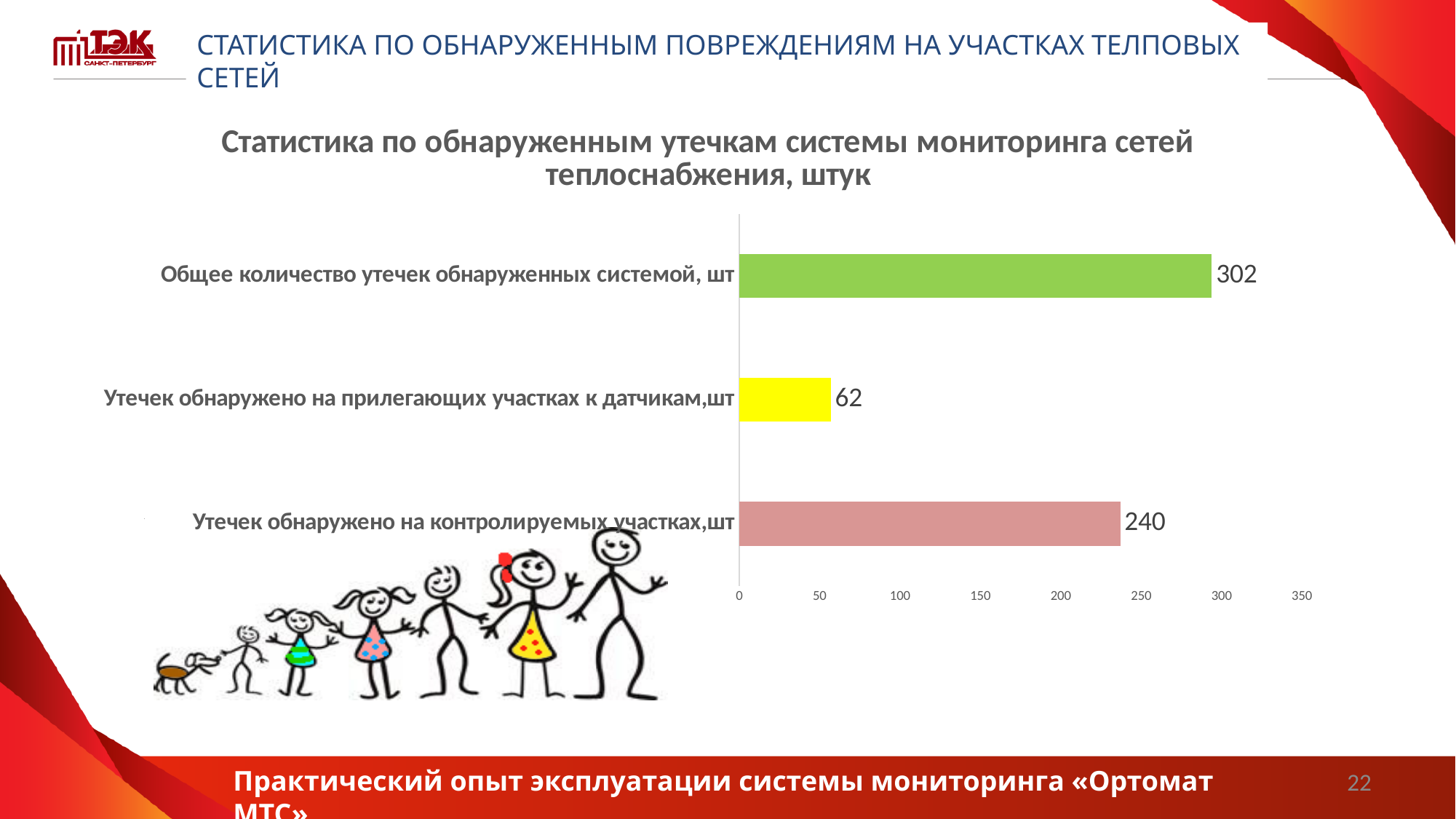
Which category has the lowest value? Утечек обнаружено на прилегающих участках к датчикам,шт How many categories are shown in the chart? 3 Which is larger: the value for "Утечек обнаружено на контролируемых участках,шт" or the value for "Утечек обнаружено на прилегающих участках к датчикам,шт"? Утечек обнаружено на контролируемых участках,шт What kind of chart is shown on the slide? Bar chart What is the value for "Общее количество утечек обнаруженных системой, шт"? 302 Is the value for "Утечек обнаружено на контролируемых участках,шт" greater or less than 200? greater What is the value for "Утечек обнаружено на прилегающих участках к датчикам,шт"? 62 What is the value for "Утечек обнаружено на контролируемых участках,шт"? 240 What is the difference between the value for "Утечек обнаружено на контролируемых участках,шт" and the value for "Утечек обнаружено на прилегающих участках к датчикам,шт"? 178 What is the difference between the total number of leaks detected by the system and the number detected on controlled sections? 62 What is the title of the chart? Статистика по обнаруженным утечкам системы мониторинга сетей теплоснабжения, штук Which category has the highest value? Общее количество утечек обнаруженных системой, шт